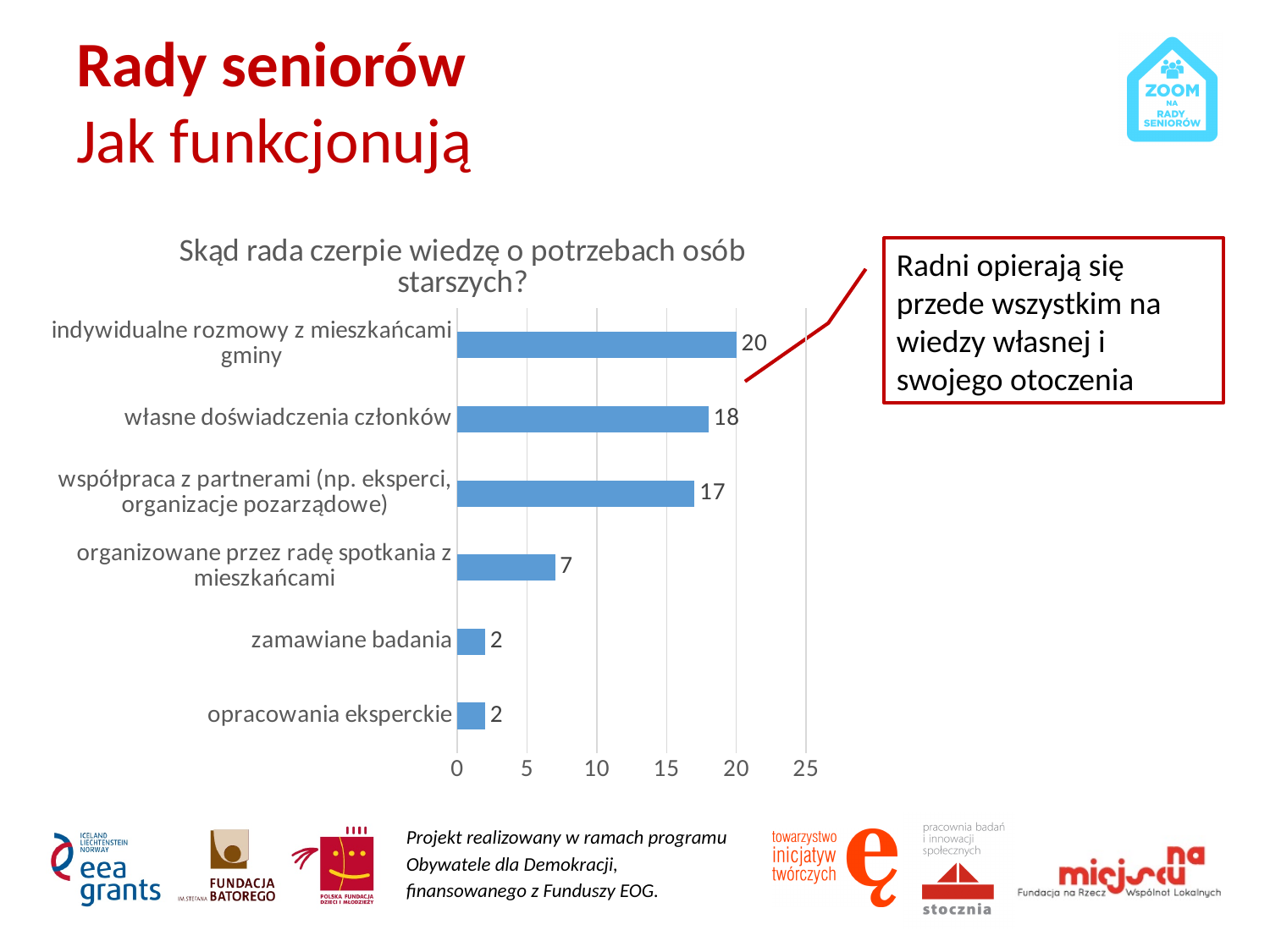
What is the difference between the values for "własne doświadczenia członków" and "opracowania eksperckie"? 16 What is the value for "własne doświadczenia członków"? 18 Which category has the highest value? indywidualne rozmowy z mieszkańcami gminy What is the value for "organizowane przez radę spotkania z mieszkańcami"? 7 How many categories are shown in the chart? 6 What kind of chart is shown on the slide? bar chart What is the difference between the values for "indywidualne rozmowy z mieszkańcami gminy" and "organizowane przez radę spotkania z mieszkańcami"? 13 What is the value for "zamawiane badania"? 2 What is the value for "współpraca z partnerami (np. eksperci, organizacje pozarządowe)"? 17 Which is larger: the value for "własne doświadczenia członków" or for "współpraca z partnerami (np. eksperci, organizacje pozarządowe)"? własne doświadczenia członków What is the value for "indywidualne rozmowy z mieszkańcami gminy"? 20 What is the title of the chart? Skąd rada czerpie wiedzę o potrzebach osób starszych?